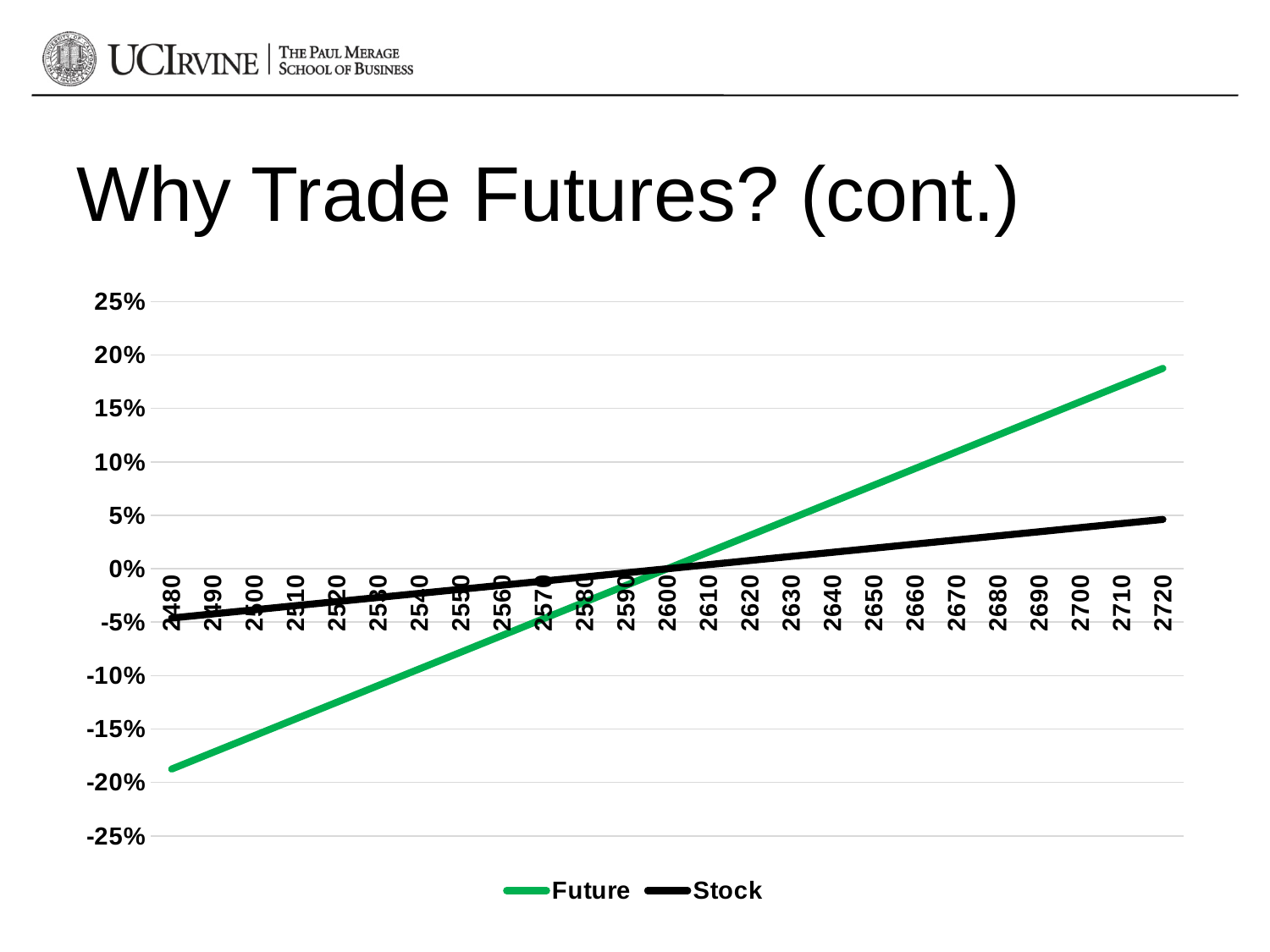
Is the Stock value at 2720 greater or less than 10%? less How many values are labelled along the x axis? 25 How many series does the legend list? 2 Does the Stock line rise or fall as the x-axis value increases from 2480 to 2720? rise What kind of chart is shown on the slide? line chart At 2480, which series has the lower value, Future or Stock? Future Which series are listed in the legend? Future and Stock Is the Future value at 2720 greater or less than 15%? greater What colour is the Future line? green Is the Future value at 2480 greater or less than -15%? less Does the Future line rise or fall as the x-axis value increases from 2480 to 2720? rise At 2720, which series has the higher value, Future or Stock? Future